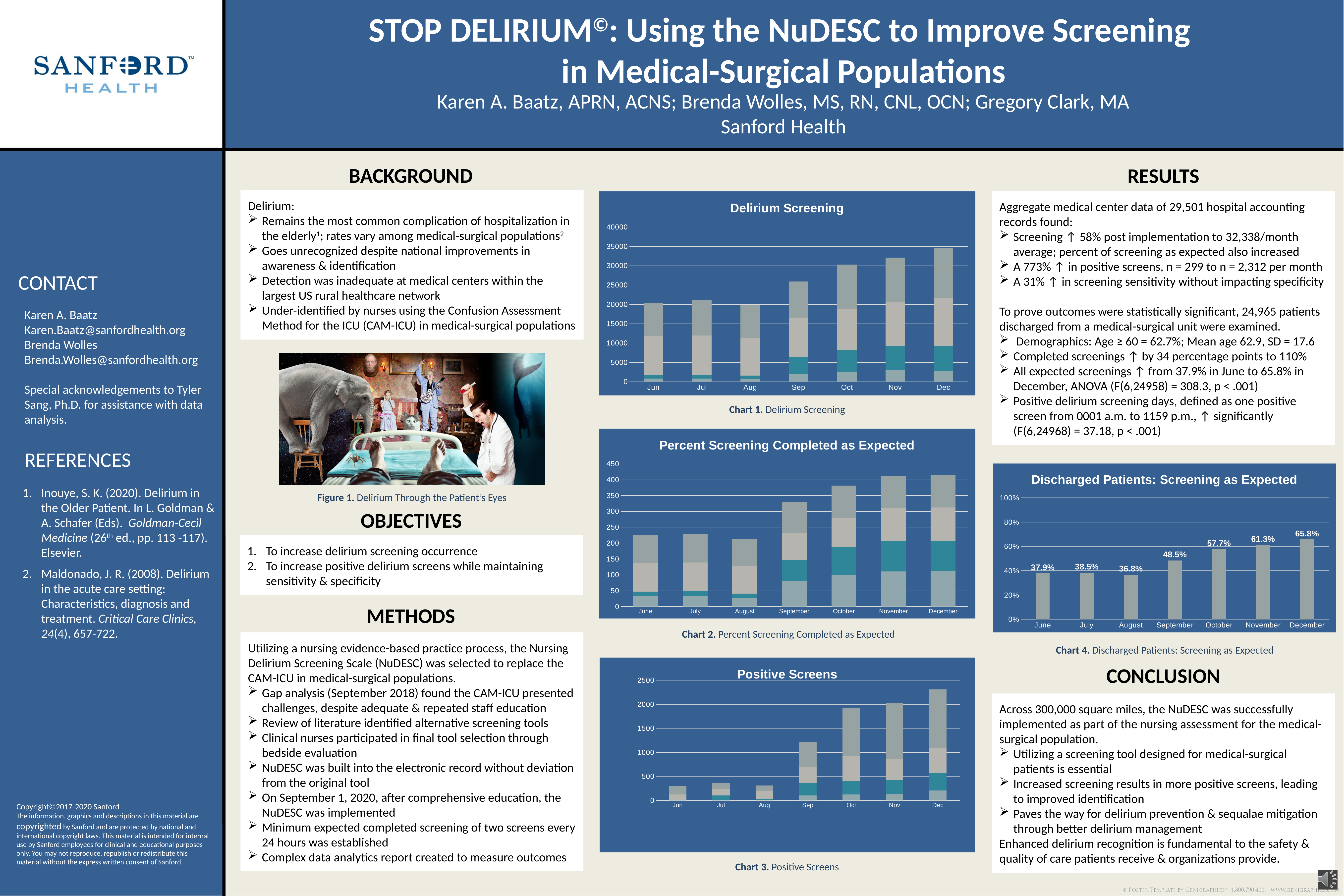
In the 'Discharged Patients: Screening as Expected' chart, do the values generally rise or fall from June to December? rise In the 'Positive Screens' chart, is the total for Sep greater or less than 1000? greater In the 'Discharged Patients: Screening as Expected' chart, what is the value for June? 37.9% How many months are shown on the x axis of the 'Delirium Screening' chart? 7 What kind of chart is the 'Positive Screens' chart? stacked bar chart In the 'Delirium Screening' chart, is the total for Dec greater or less than 30000? greater In the 'Discharged Patients: Screening as Expected' chart, which month has the lowest value? August In the 'Discharged Patients: Screening as Expected' chart, what is the difference between the December and June values? 27.9% In the 'Discharged Patients: Screening as Expected' chart, which is larger, the value for October or the value for September? October In the 'Discharged Patients: Screening as Expected' chart, which month has the highest value? December In the 'Discharged Patients: Screening as Expected' chart, what is the value for December? 65.8% In the 'Delirium Screening' chart, which month has the tallest stacked bar? Dec